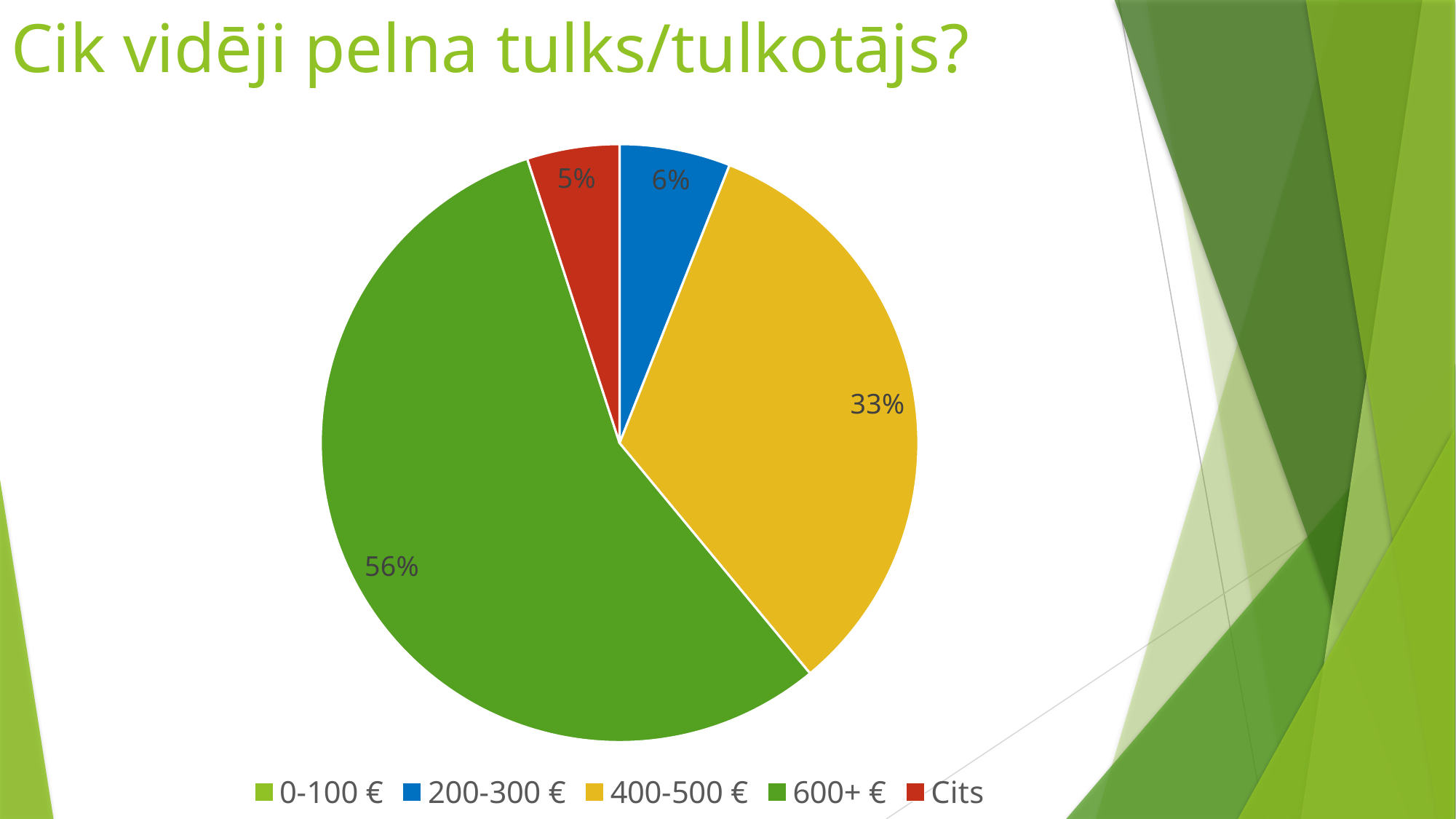
How many categories does the legend list? 5 What is the title of the slide? Cik vidēji pelna tulks/tulkotājs? Which slice is larger, 200-300 € or 400-500 €? 400-500 € Which labelled slice of the pie is the smallest? Cits What percentage of the pie is the 200-300 € slice? 6% What percentage of the pie is the Cits slice? 5% What is the difference in percentage points between the 600+ € slice and the 400-500 € slice? 23 What kind of chart is shown on the slide? pie chart Which category has the largest slice of the pie? 600+ € What percentage of the pie is the 400-500 € slice? 33% Is the share for 600+ € greater or less than 50%? greater What percentage of the pie is the 600+ € slice? 56%